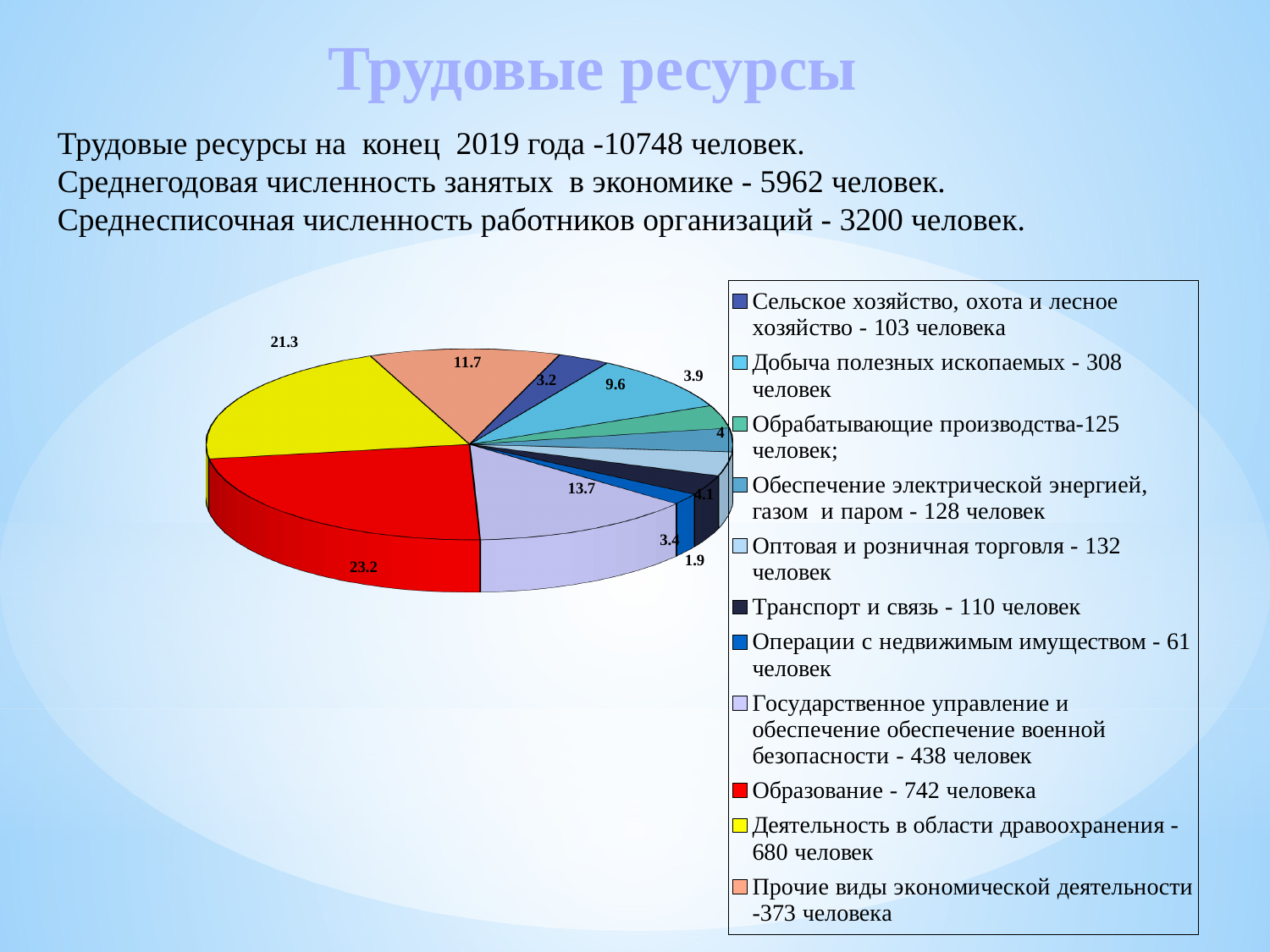
What percentage label is shown on the yellow slice (Деятельность в области здравоохранения)? 21.3 What percentage label is shown for Добыча полезных ископаемых? 9.6 Which category has the smallest slice of the pie? Операции с недвижимым имуществом Which slice is larger: Прочие виды экономической деятельности or Добыча полезных ископаемых? Прочие виды экономической деятельности What percentage label is shown for Государственное управление и обеспечение военной безопасности? 13.7 What colour is the slice for Деятельность в области здравоохранения? yellow What percentage label is shown on the red slice (Образование)? 23.2 According to the legend, how many people work in Образование? 742 человека What kind of chart is shown on the slide? pie chart Which category has the largest slice of the pie? Образование What is the difference between the percentage labels for Образование and Деятельность в области здравоохранения? 1.9 How many categories does the pie chart's legend list? 11